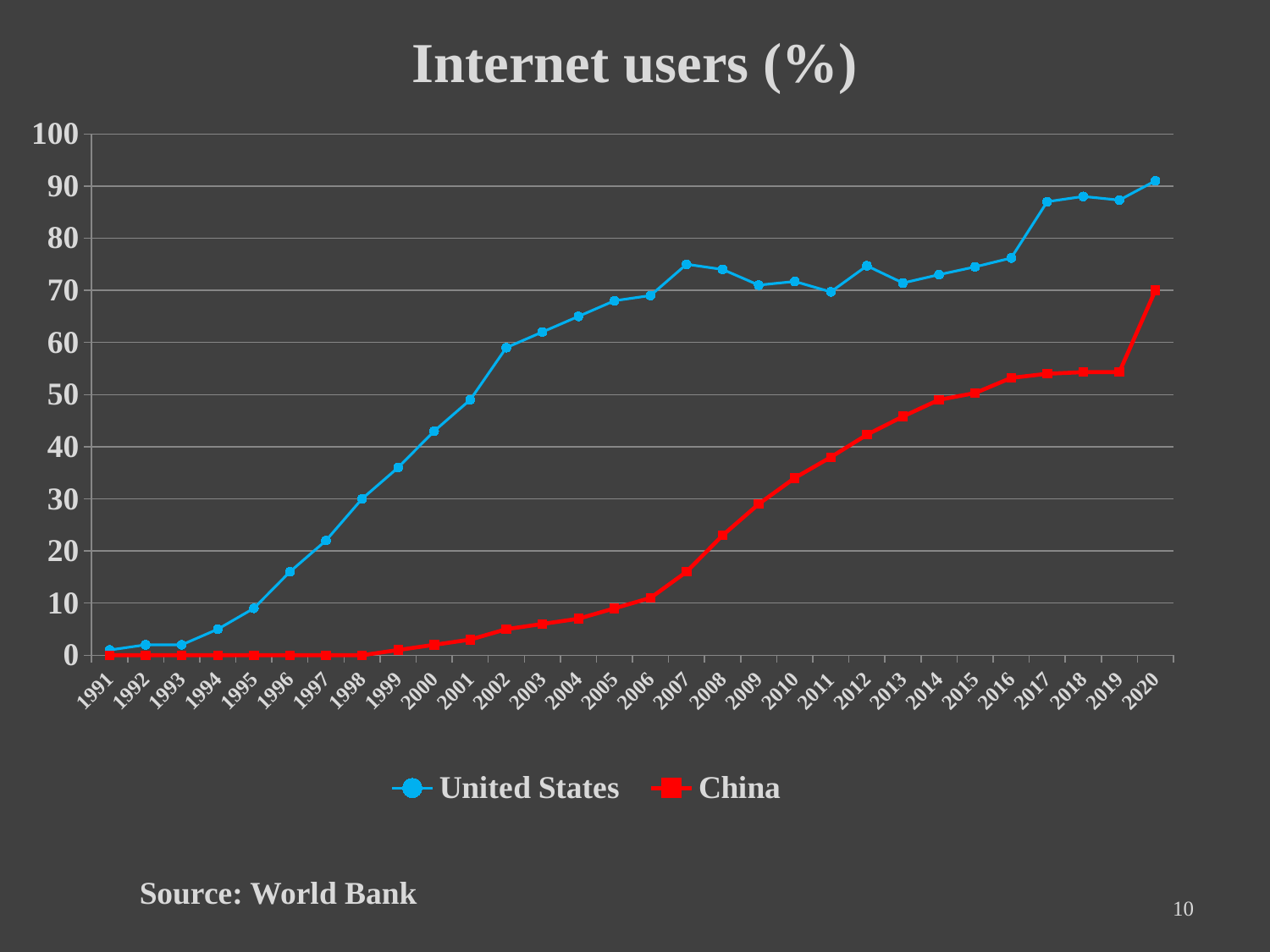
In which year does the China series reach its highest value? 2020 What is the title of the chart? Internet users (%) What kind of chart is shown on the slide? line chart Does the China series rise or fall from 1991 to 2020? rise Is the value for China in 2015 greater or less than 40? greater In which year does the United States series reach its highest value? 2020 In 2010, which series has the larger value, United States or China? United States How many years are plotted along the x axis? 30 Is the value for China in 2005 greater or less than 20? less Which is larger for the United States: the value in 2007 or the value in 2011? 2007 Is the value for the United States in 2002 greater or less than 50? greater How many series does the legend list? 2